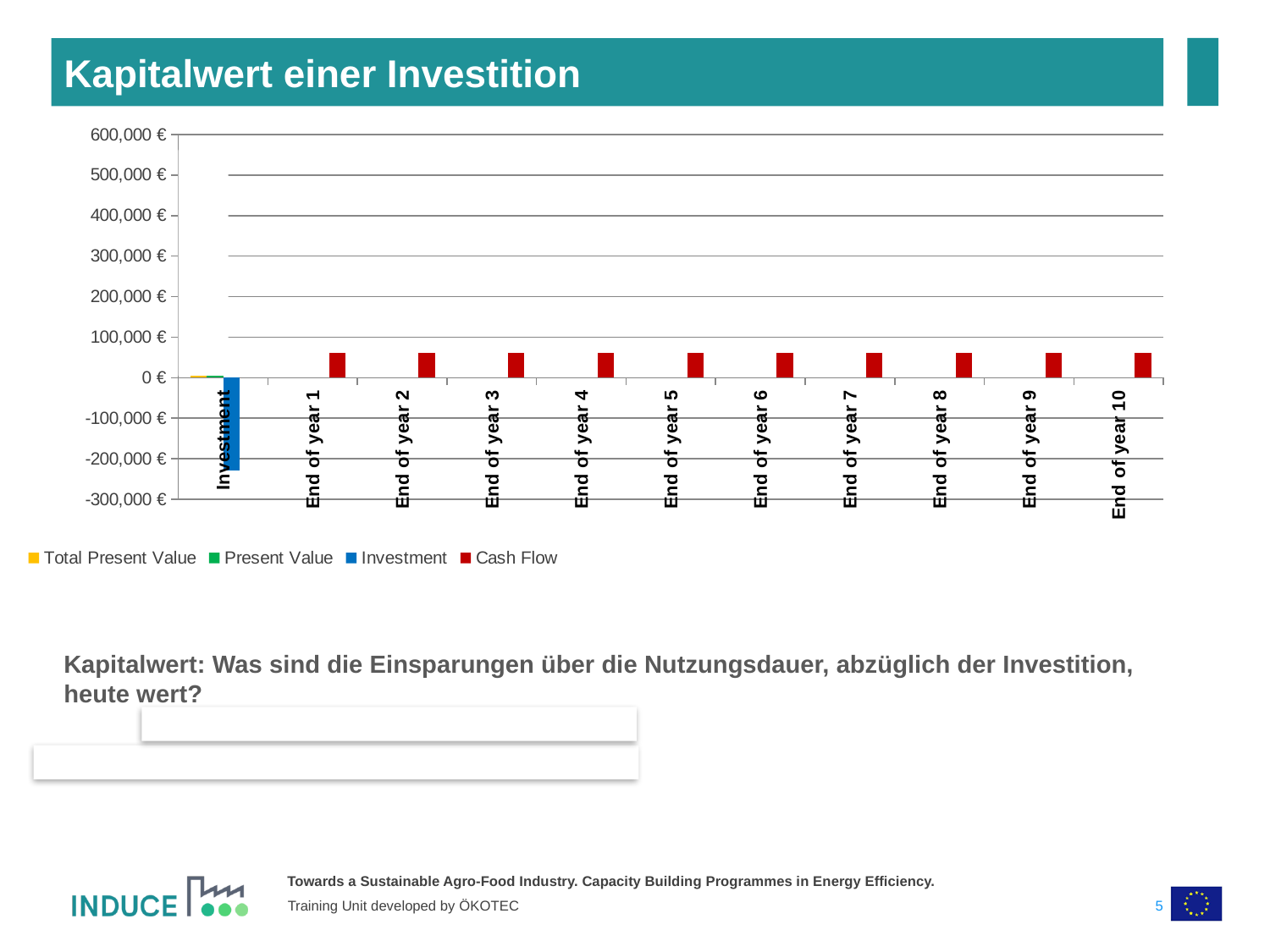
Which is larger: the Investment value or the Cash Flow value at End of year 1? Cash Flow at End of year 1 Is the Cash Flow value at End of year 1 greater or less than 100,000 €? less What kind of chart is shown on the slide? bar chart How many categories are shown along the x axis of the chart? 11 Which category has the lowest value in the chart? Investment Is the Investment value greater or less than -200,000 €? less Do the Cash Flow values rise, fall, or stay roughly the same from End of year 1 to End of year 10? stay roughly the same What are the four series listed in the chart's legend? Total Present Value, Present Value, Investment, Cash Flow Is the Cash Flow value at End of year 5 greater or less than 0 €? greater How many series does the chart's legend list? 4 What colour represents the Cash Flow series in the chart? red